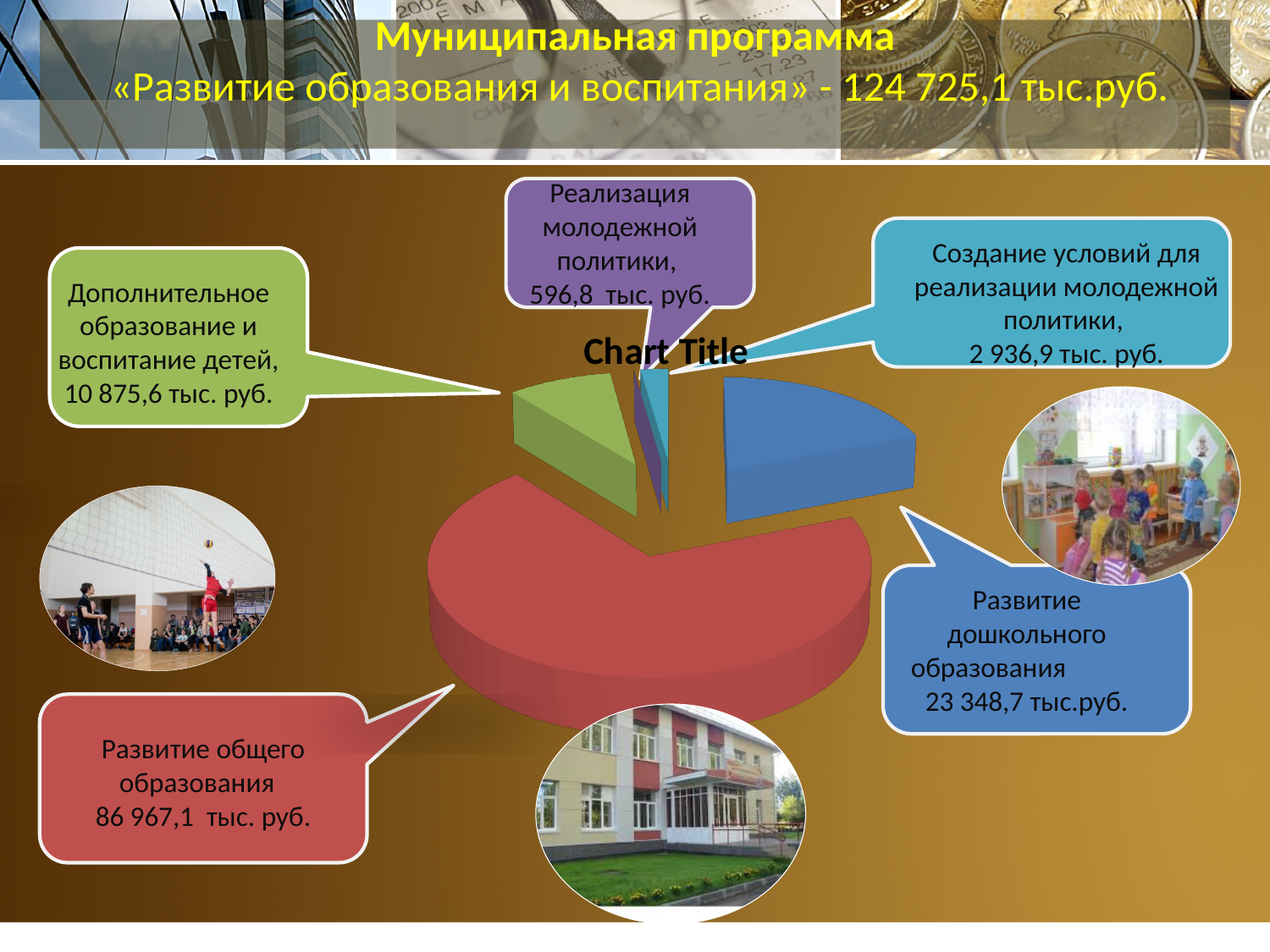
Which is larger: «Развитие дошкольного образования» or «Дополнительное образование и воспитание детей»? Развитие дошкольного образования What is the value for «Дополнительное образование и воспитание детей»? 10 875,6 тыс. руб. How many slices does the pie chart have? 5 What is the chart's title as printed on the slide? Chart Title What colour is the slice for «Развитие общего образования»? red Which category has the smallest slice of the pie? Реализация молодежной политики What kind of chart is shown on the slide? pie chart What is the difference between «Развитие общего образования» and «Развитие дошкольного образования»? 63 618,4 тыс. руб. What is the value for «Реализация молодежной политики»? 596,8 тыс. руб. Which category has the largest slice of the pie? Развитие общего образования What is the value for «Развитие дошкольного образования»? 23 348,7 тыс.руб. What is the value for «Развитие общего образования»? 86 967,1 тыс. руб.